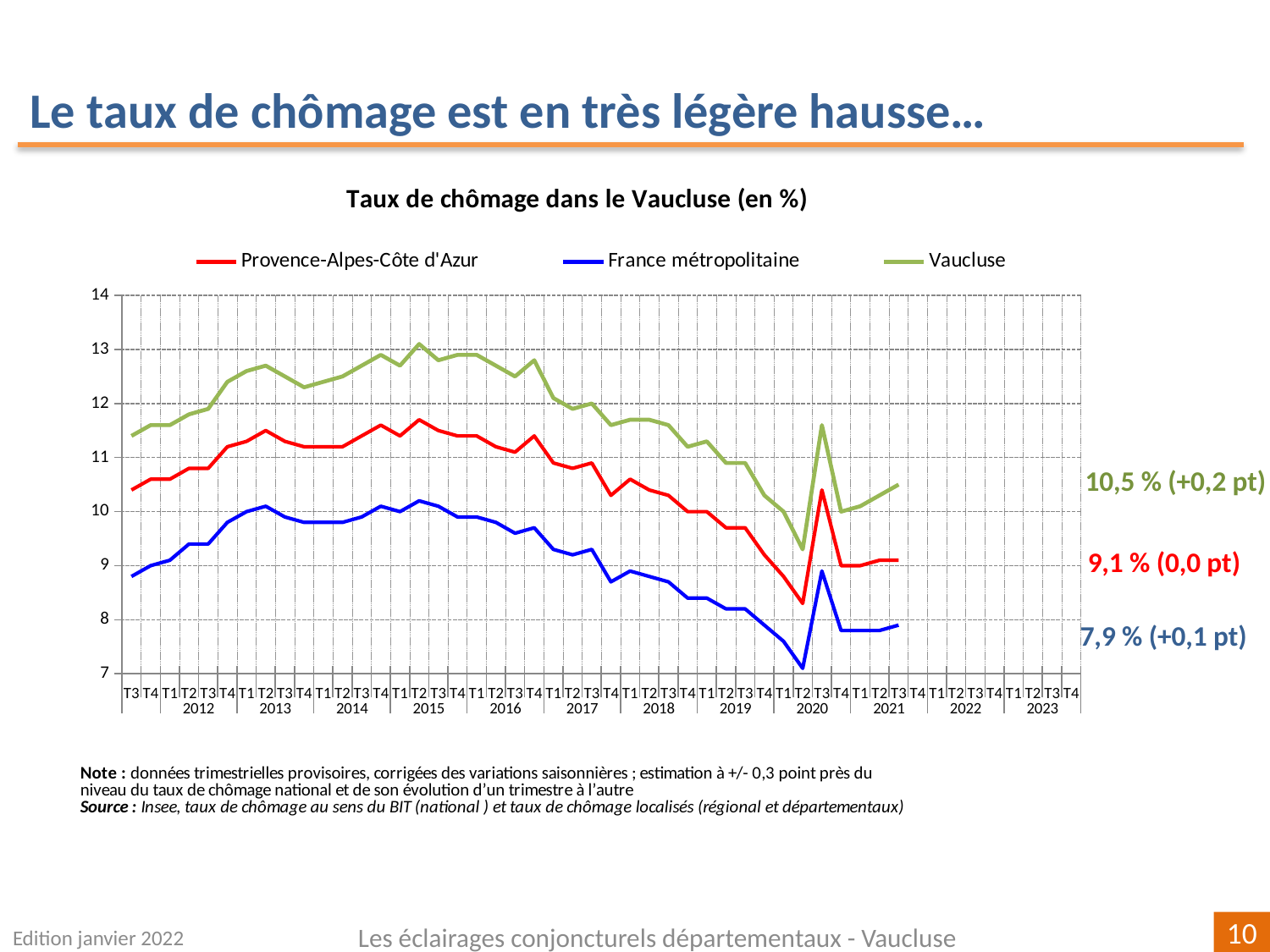
Does the Vaucluse line rise or fall between 2016 and 2019? fall Which series has the highest values across the whole period? Vaucluse What is the latest unemployment rate shown for France métropolitaine? 7,9 % Which series has the lowest values across the whole period? France métropolitaine Is the France métropolitaine value in T2 2020 greater or less than 8? less What is the difference between the latest Vaucluse rate (10,5 %) and the latest France métropolitaine rate (7,9 %)? 2,6 points What is the latest unemployment rate shown for Vaucluse? 10,5 % What kind of chart is shown on the slide? line chart What is the latest unemployment rate shown for Provence-Alpes-Côte d'Azur? 9,1 % What is the title of the chart? Taux de chômage dans le Vaucluse (en %) How many series does the legend list? 3 By how much did the Vaucluse rate change over the last quarter, according to the label? +0,2 pt